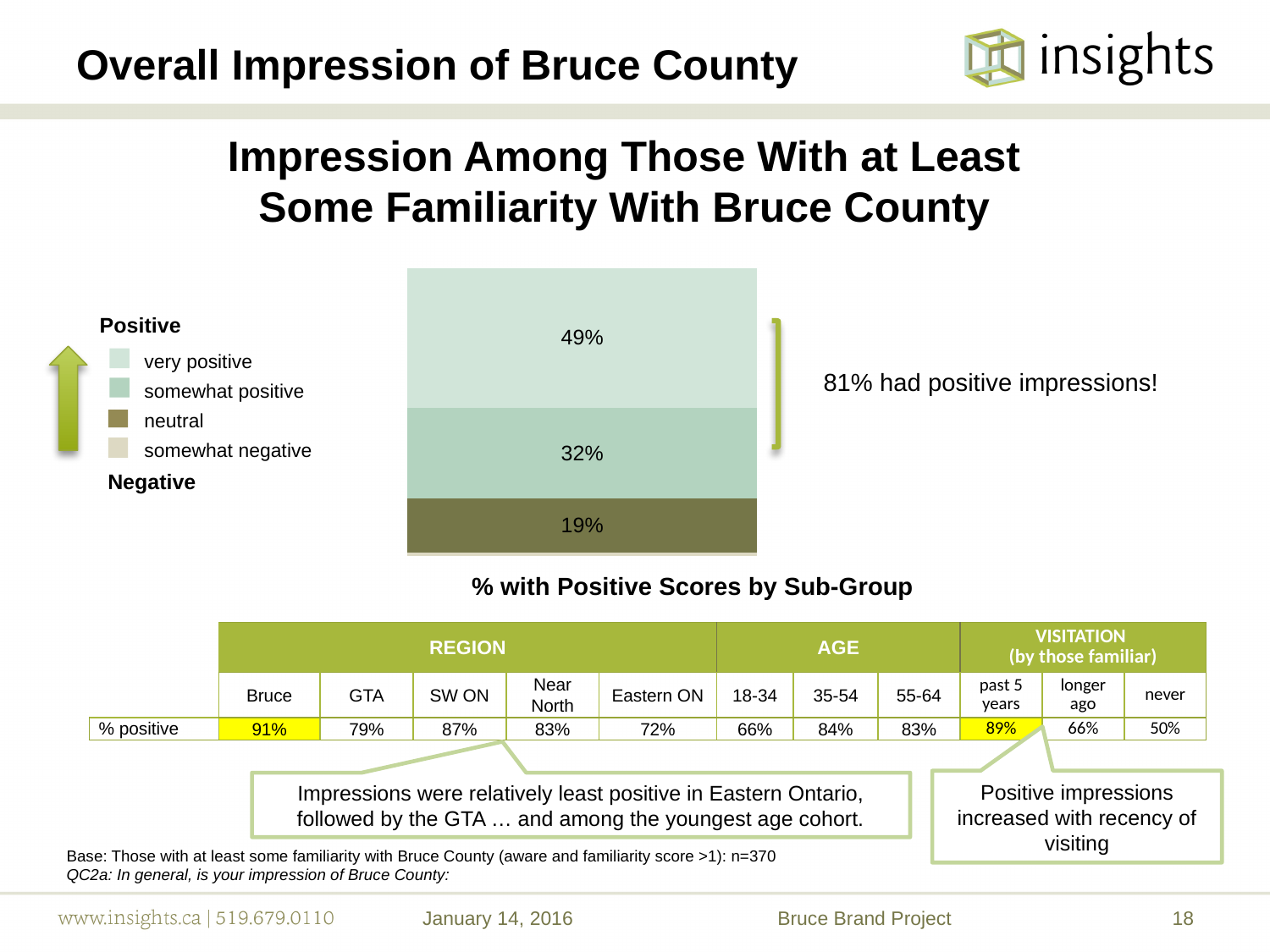
According to the callout next to the bar, what percentage had positive impressions? 81% Which segment of the stacked bar has the largest value? very positive (49%) What percentage is shown in the bottom (darkest) segment of the stacked bar? 19% Which is larger: the 'somewhat positive' segment or the 'neutral' segment? somewhat positive What is the difference between the top segment (49%) and the middle segment (32%) of the bar? 17 percentage points Which segment of the stacked bar has the smallest value? neutral (19%) What is the difference between the middle segment (32%) and the bottom segment (19%) of the bar? 13 percentage points How many segments are shown in the stacked bar? 3 What percentage is shown in the top segment of the stacked bar? 49% What is the total of the three segments shown in the stacked bar? 100% What type of chart is used to show the impression results? stacked bar chart What percentage of respondents gave a 'somewhat positive' impression, according to the middle segment of the bar? 32%